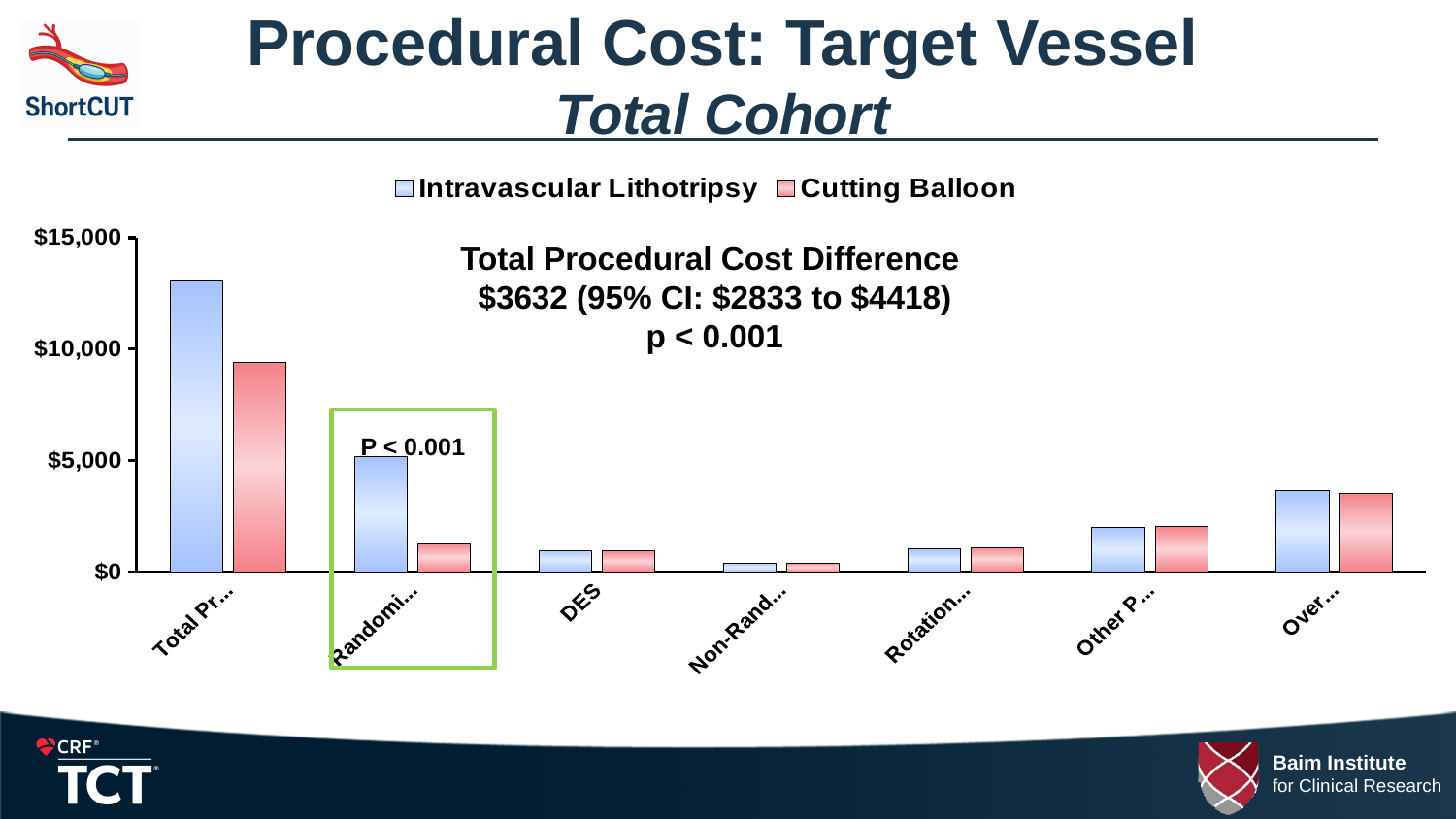
Is the Cutting Balloon value for the leftmost category (Total Pr...) greater or less than $10,000? less Is the Intravascular Lithotripsy value for the rightmost category (Over...) greater or less than $5,000? less What kind of chart is shown on the slide? Bar chart Is the Intravascular Lithotripsy value for the leftmost category (Total Pr...) greater or less than $10,000? greater Which category has the lowest Intravascular Lithotripsy value? Non-Rand... (the fourth category) How many series does the chart legend list? 2 What total procedural cost difference is printed on the chart? $3632 (95% CI: $2833 to $4418) How many categories are shown along the x axis of the chart? 7 Which category has the highest Intravascular Lithotripsy value? Total Pr... (the leftmost category) In the second category from the left (Randomi...), which series has the larger value, Intravascular Lithotripsy or Cutting Balloon? Intravascular Lithotripsy What are the two series named in the chart legend? Intravascular Lithotripsy and Cutting Balloon